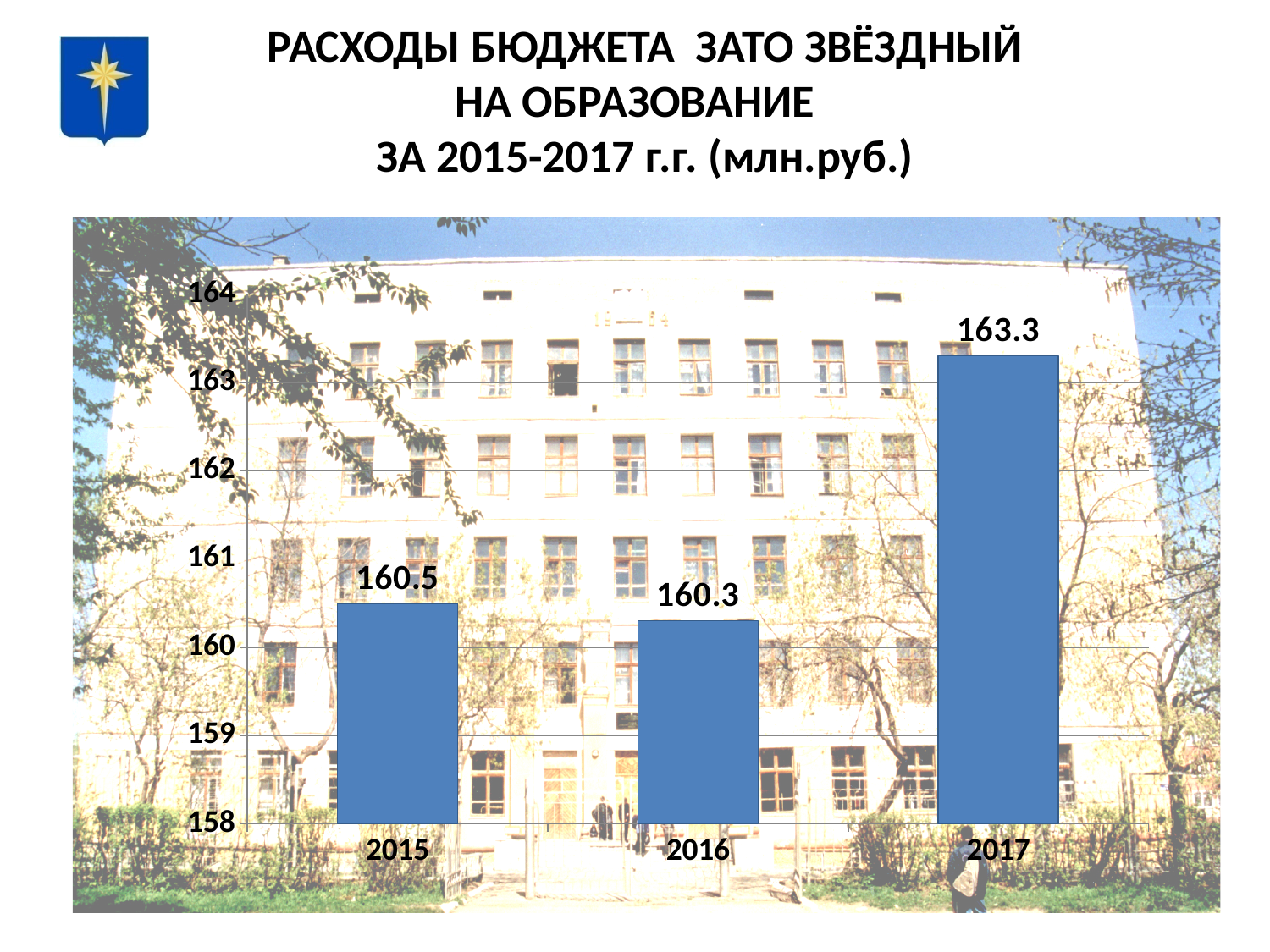
Which year has the highest value? 2017 What is the value for 2016? 160.3 How many years are shown on the chart? 3 Which is larger, the value for 2017 or the value for 2016? 2017 What is the difference between the values for 2015 and 2016? 0.2 What is the value for 2017? 163.3 Which year has the lowest value? 2016 What unit is given in the chart title? млн.руб. What is the value for 2015? 160.5 Is the value for 2017 greater or less than 163? greater What is the difference between the values for 2017 and 2015? 2.8 What kind of chart is shown on the slide? bar chart